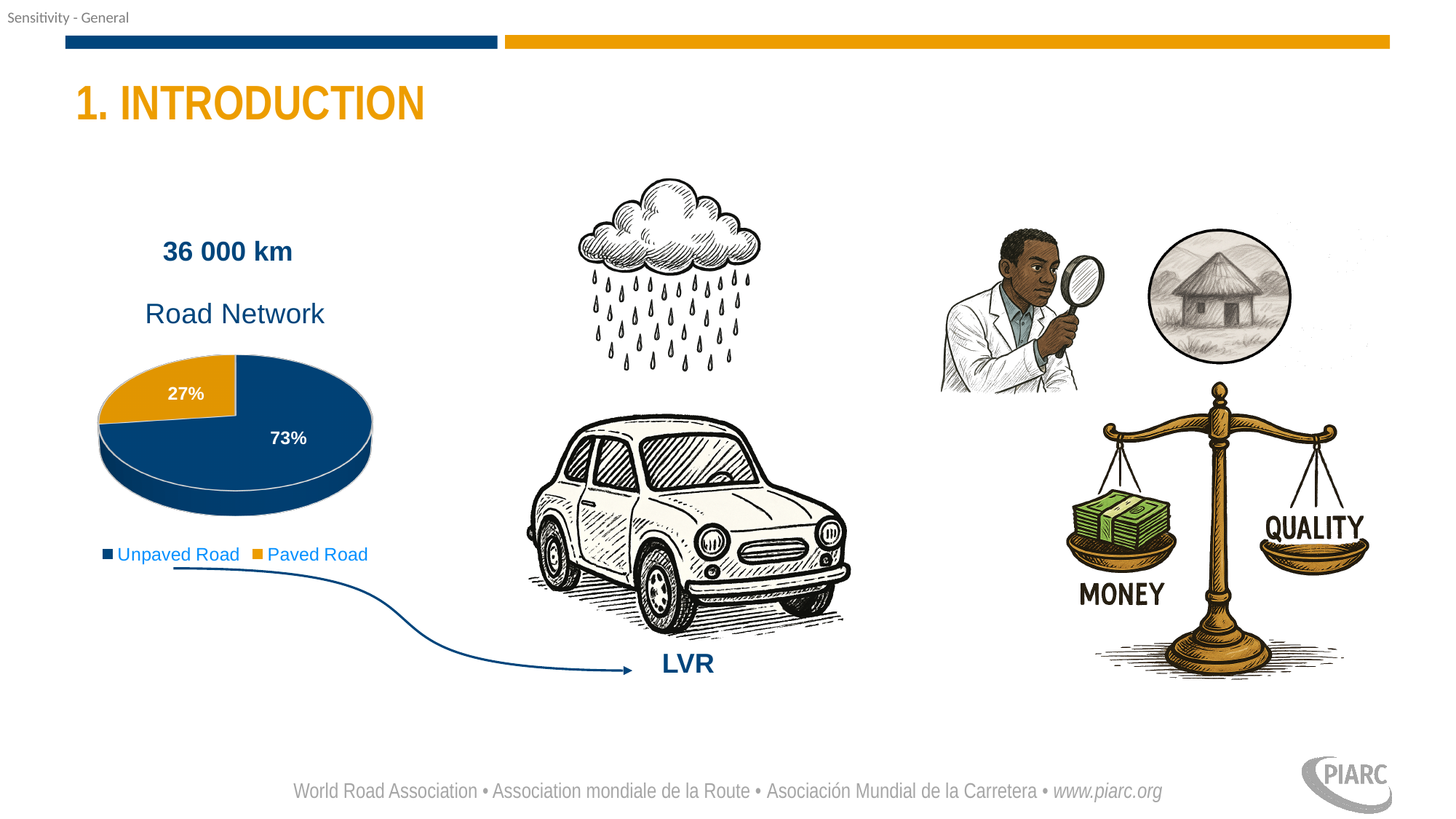
What share of the Road Network pie chart is Unpaved Road? 73% What is the difference in percentage points between the Unpaved Road and Paved Road slices? 46 Which category has the largest slice in the Road Network pie chart? Unpaved Road What is the title of the pie chart? Road Network What kind of chart is used to show the Road Network? Pie chart What share of the Road Network pie chart is Paved Road? 27% How many slices does the Road Network pie chart have? 2 What colour is the Paved Road slice in the pie chart? Orange What total length of road network is stated above the pie chart? 36 000 km Which is larger in the Road Network pie chart, Unpaved Road or Paved Road? Unpaved Road Which category has the smallest slice in the Road Network pie chart? Paved Road